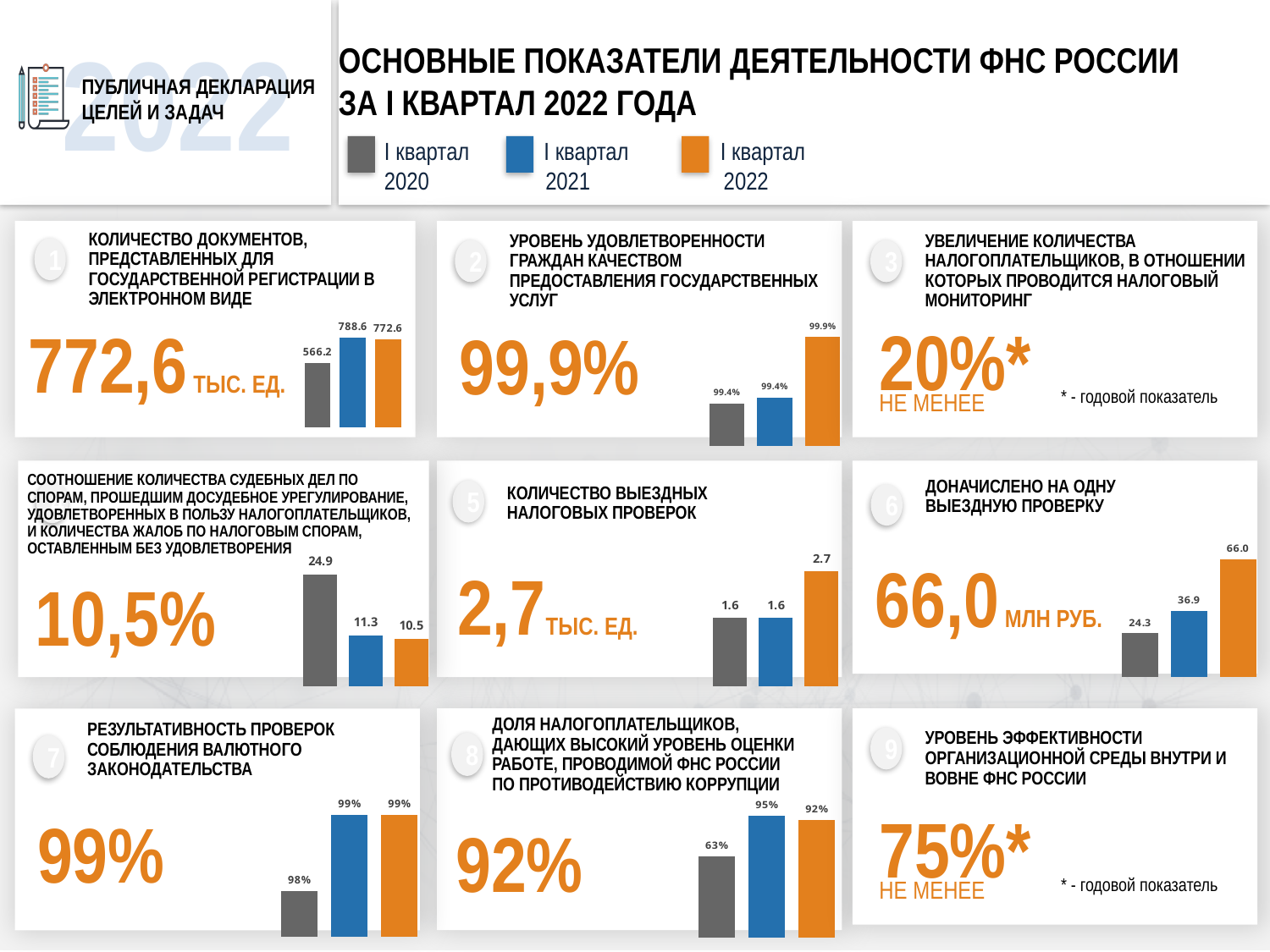
In the chart for panel 5 (Количество выездных налоговых проверок), what is the value for I квартал 2022? 2.7 In the chart for panel 1 (Количество документов, представленных для государственной регистрации в электронном виде), what is the value for I квартал 2021? 788.6 How many series does the legend at the top of the slide list? 3 In the chart for panel 6 (Доначислено на одну выездную проверку), do the values rise or fall from I квартал 2020 to I квартал 2022? rise In the chart for panel 4 (Соотношение количества судебных дел...), do the values rise or fall from I квартал 2020 to I квартал 2022? fall In the chart for panel 2 (Уровень удовлетворенности граждан...), what is the value for I квартал 2022? 99.9% In the chart for panel 8 (Доля налогоплательщиков, дающих высокий уровень оценки...), which is larger: the value for I квартал 2021 or I квартал 2022? I квартал 2021 In the chart for panel 6 (Доначислено на одну выездную проверку), what is the difference between the I квартал 2022 and I квартал 2021 values? 29.1 In the chart for panel 1 (Количество документов...), which quarter has the lowest value? I квартал 2020 In the chart for panel 7 (Результативность проверок соблюдения валютного законодательства), what is the value for I квартал 2020? 98% In the chart for panel 4 (Соотношение количества судебных дел...), which quarter has the highest value? I квартал 2020 In the chart for panel 1 (Количество документов...), what is the difference between the I квартал 2021 and I квартал 2020 values? 222.4